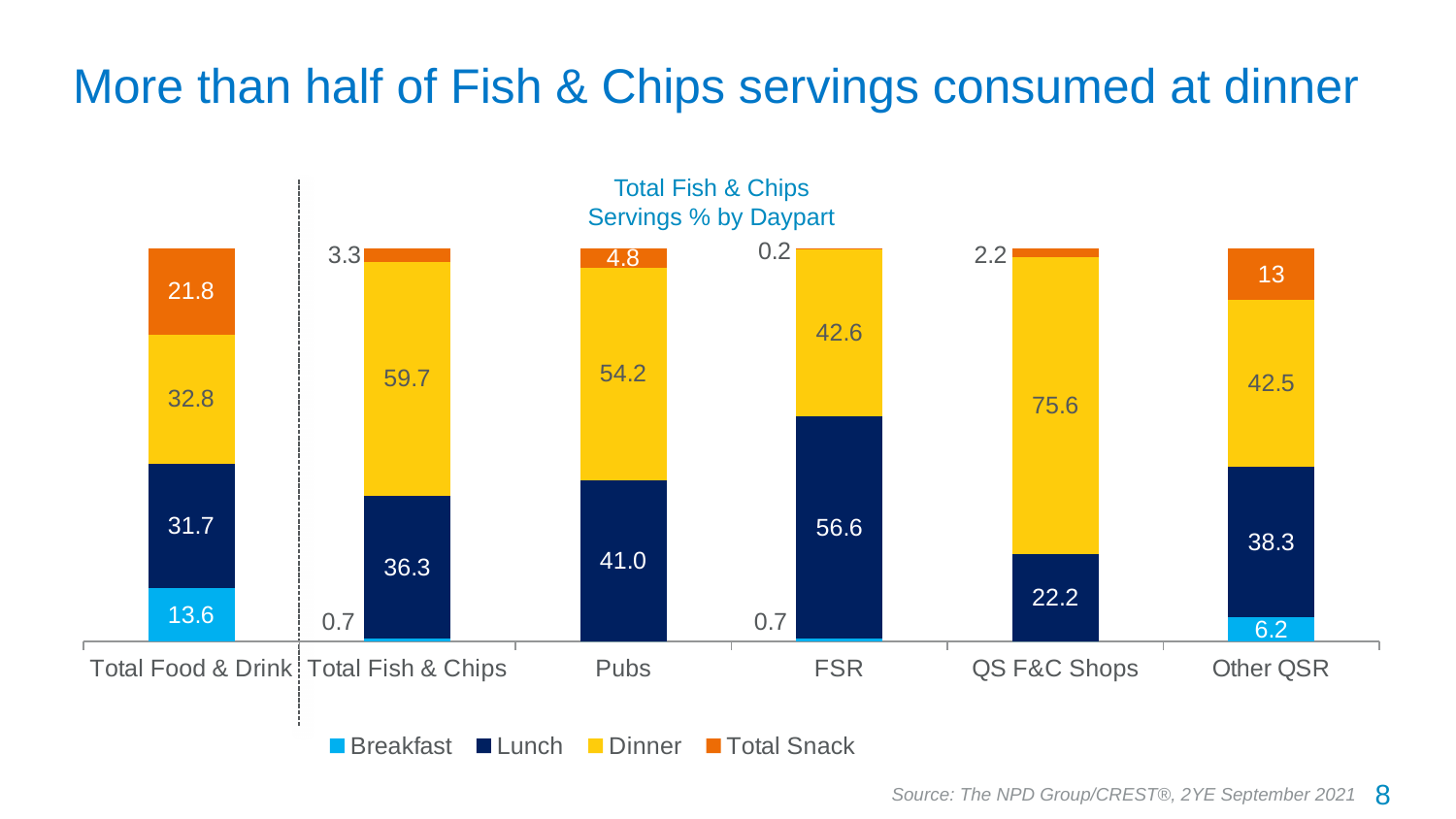
What is the Dinner value for QS F&C Shops? 75.6 How many categories are shown on the x axis? 6 Which category has the lowest Lunch value? QS F&C Shops What kind of chart is shown on the slide? Stacked bar chart How many series does the legend list? 4 What is the Breakfast value for Total Food & Drink? 13.6 What is the Lunch value for FSR? 56.6 For FSR, which is larger: the Lunch value or the Dinner value? Lunch What is the total of the stacked bar for Other QSR? 100 What is the Total Snack value for Other QSR? 13 Which category has the highest Dinner value? QS F&C Shops For Total Fish & Chips, how much larger is the Dinner value than the Lunch value? 23.4